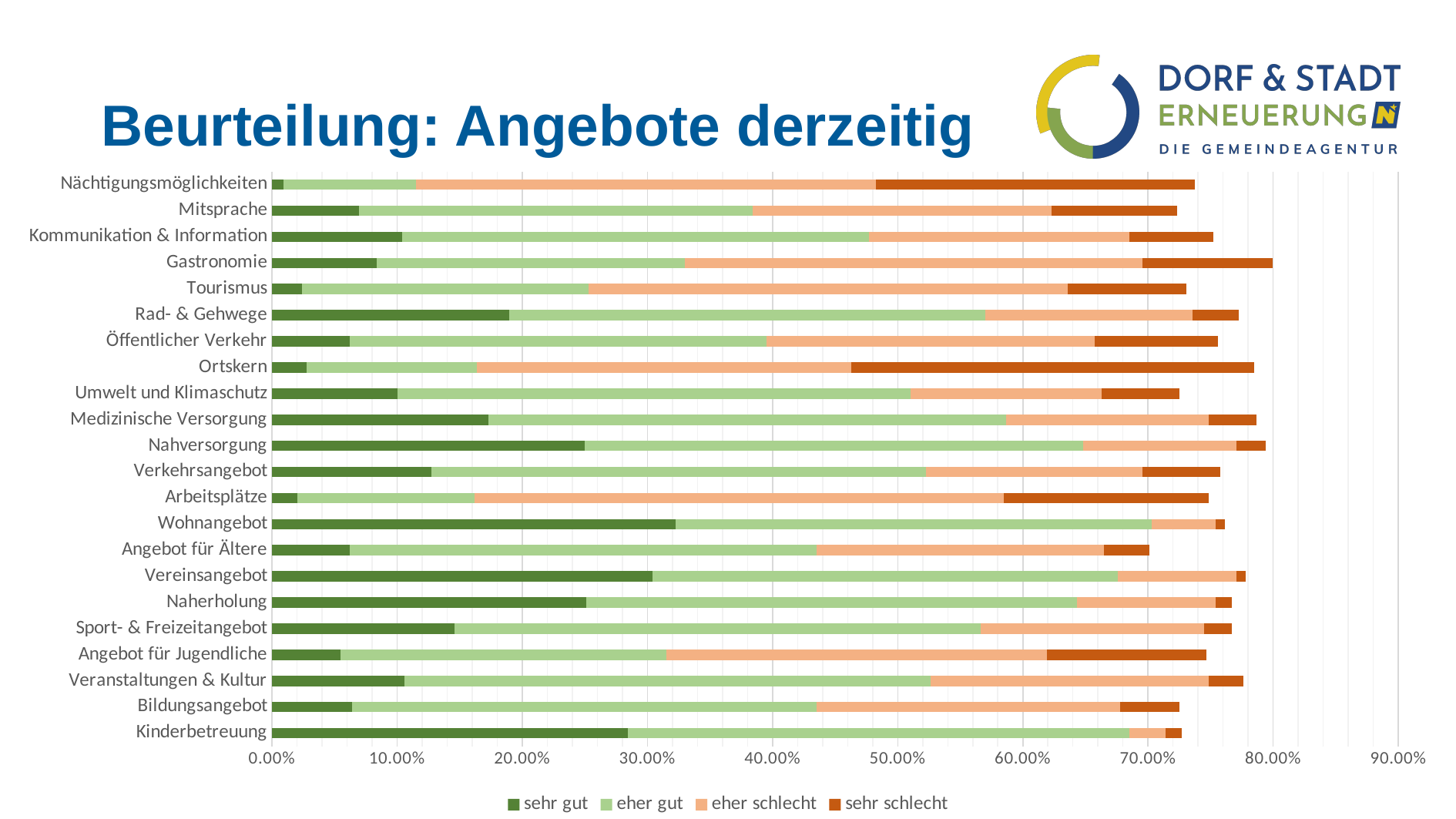
Is the total bar length for Gastronomie greater or less than 70%? greater Which series is listed first in the chart legend? sehr gut Which has the larger 'sehr gut' value, Wohnangebot or Kinderbetreuung? Wohnangebot How many series does the chart legend list? 4 Is the 'sehr gut' value for Nahversorgung greater or less than 20%? greater What is the title of the slide containing the chart? Beurteilung: Angebote derzeitig Is the 'sehr gut' value for Tourismus greater or less than 10%? less How many categories are listed on the vertical axis of the chart? 22 Which category has the largest 'sehr schlecht' segment? Ortskern What kind of chart is shown on the slide? Stacked bar chart